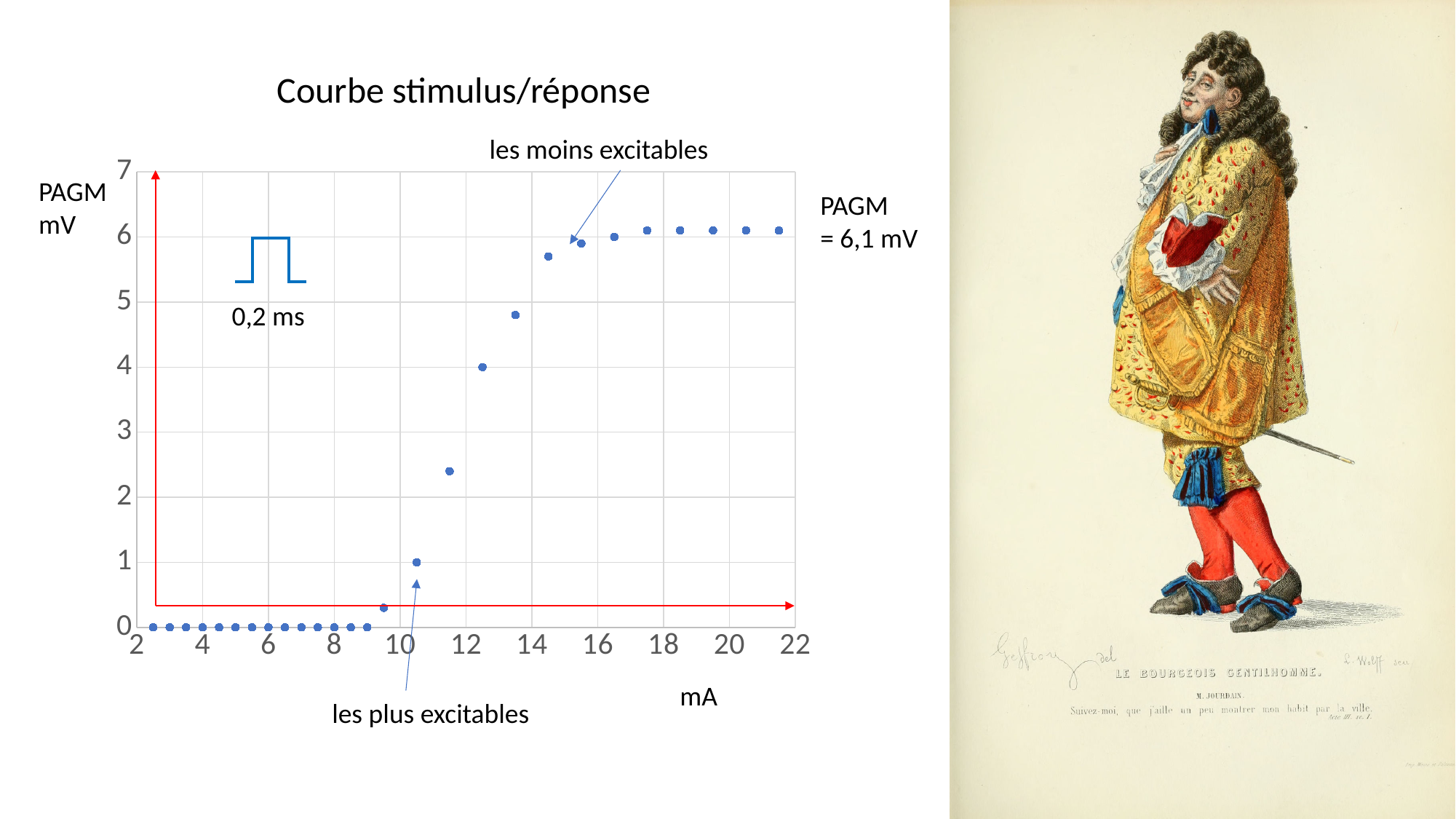
Is the PAGM value at 14.5 mA greater or less than 6? less Is the PAGM value at 13.5 mA greater or less than 4? greater What unit is shown on the x axis of the chart? mA What is the title of the chart? Courbe stimulus/réponse Which is larger, the PAGM value at 12.5 mA or at 16.5 mA? 16.5 mA Do the PAGM values rise or fall as the stimulus current increases from 10 mA to 16 mA? rise What is the PAGM value at 12.5 mA? 4 Is the PAGM value at 9.5 mA greater or less than 1? less According to the annotation on the chart, what is the plateau value of PAGM? 6,1 mV What is the PAGM value at 10.5 mA? 1 What kind of chart is shown on the slide? scatter chart